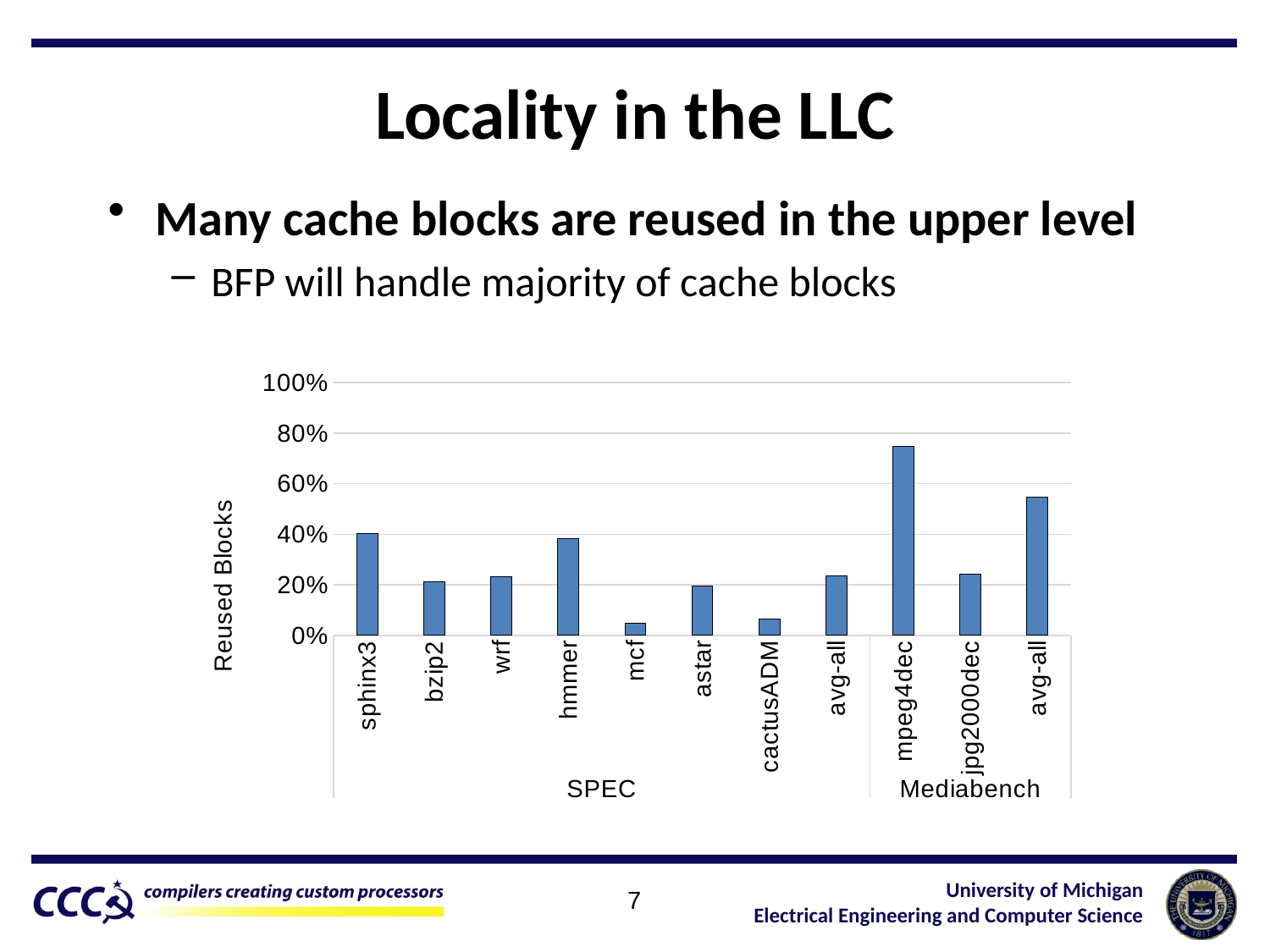
Is the value for sphinx3 greater or less than 20%? greater Is the value for mcf greater or less than 20%? less Which is larger, the value for hmmer or the value for bzip2? hmmer How many bars are plotted in the chart? 11 What kind of chart is shown on the slide? bar chart What are the two benchmark groups labelled along the x axis? SPEC and Mediabench What is the label on the vertical axis of the chart? Reused Blocks Is the value for cactusADM greater or less than 20%? less Which is larger, the value for mpeg4dec or the value for sphinx3? mpeg4dec Which category has the highest share of reused blocks? mpeg4dec